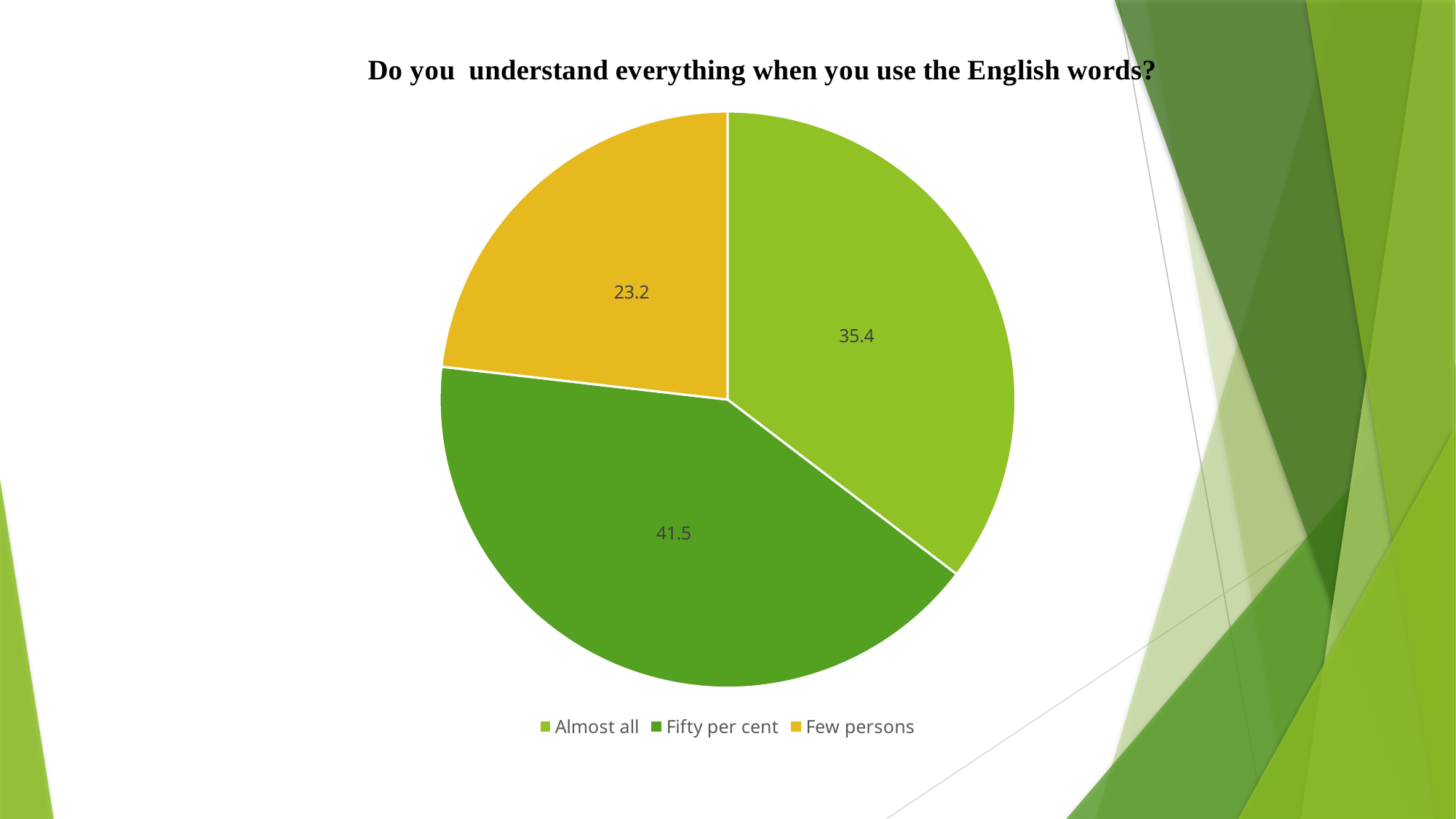
What is the value for "Almost all"? 35.4 What is the difference between the values for "Almost all" and "Few persons"? 12.2 What is the title of the chart? Do you understand everything when you use the English words? Which category is shown in yellow? Few persons What is the value for "Fifty per cent"? 41.5 Which category has the smallest slice? Few persons Which category has the largest slice? Fifty per cent How many slices does the pie chart have? 3 What is the value for "Few persons"? 23.2 What kind of chart is shown on the slide? Pie chart What is the difference between the values for "Fifty per cent" and "Almost all"? 6.1 Which is larger, the value for "Almost all" or the value for "Few persons"? Almost all